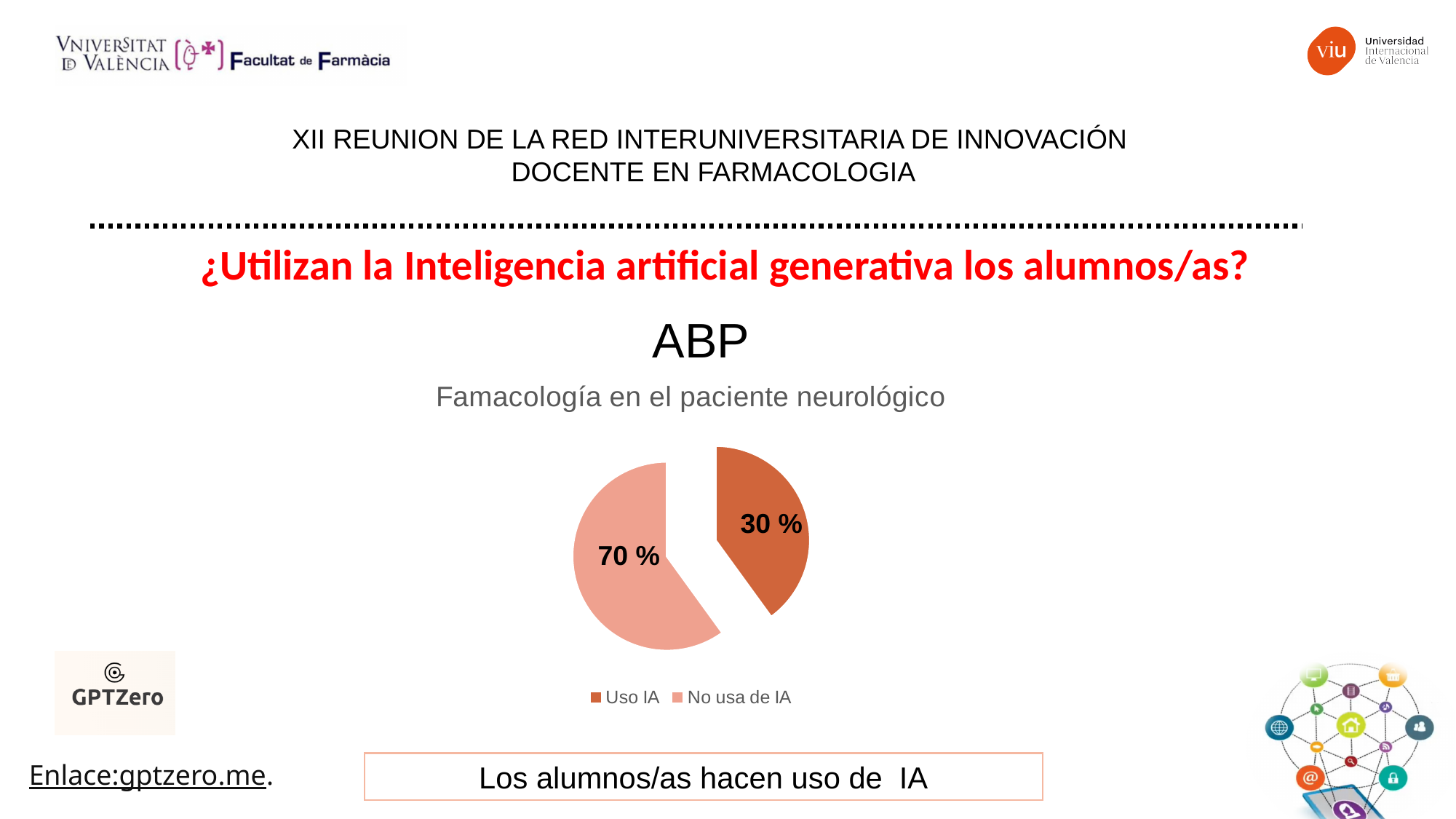
What is the value for "Uso IA" in the pie chart? 30 % Which category has the largest share of the pie chart? No usa de IA Which is larger, the share for "Uso IA" or for "No usa de IA"? No usa de IA How many slices does the pie chart have? 2 What is the value for "No usa de IA" in the pie chart? 70 % What is the title of the pie chart? Famacología en el paciente neurológico How many entries does the legend of the pie chart list? 2 What kind of chart is shown on the slide? pie chart Which category has the smallest share of the pie chart? Uso IA Which legend entry is shown in the darker orange colour? Uso IA What is the difference between the "No usa de IA" and "Uso IA" shares? 40 %